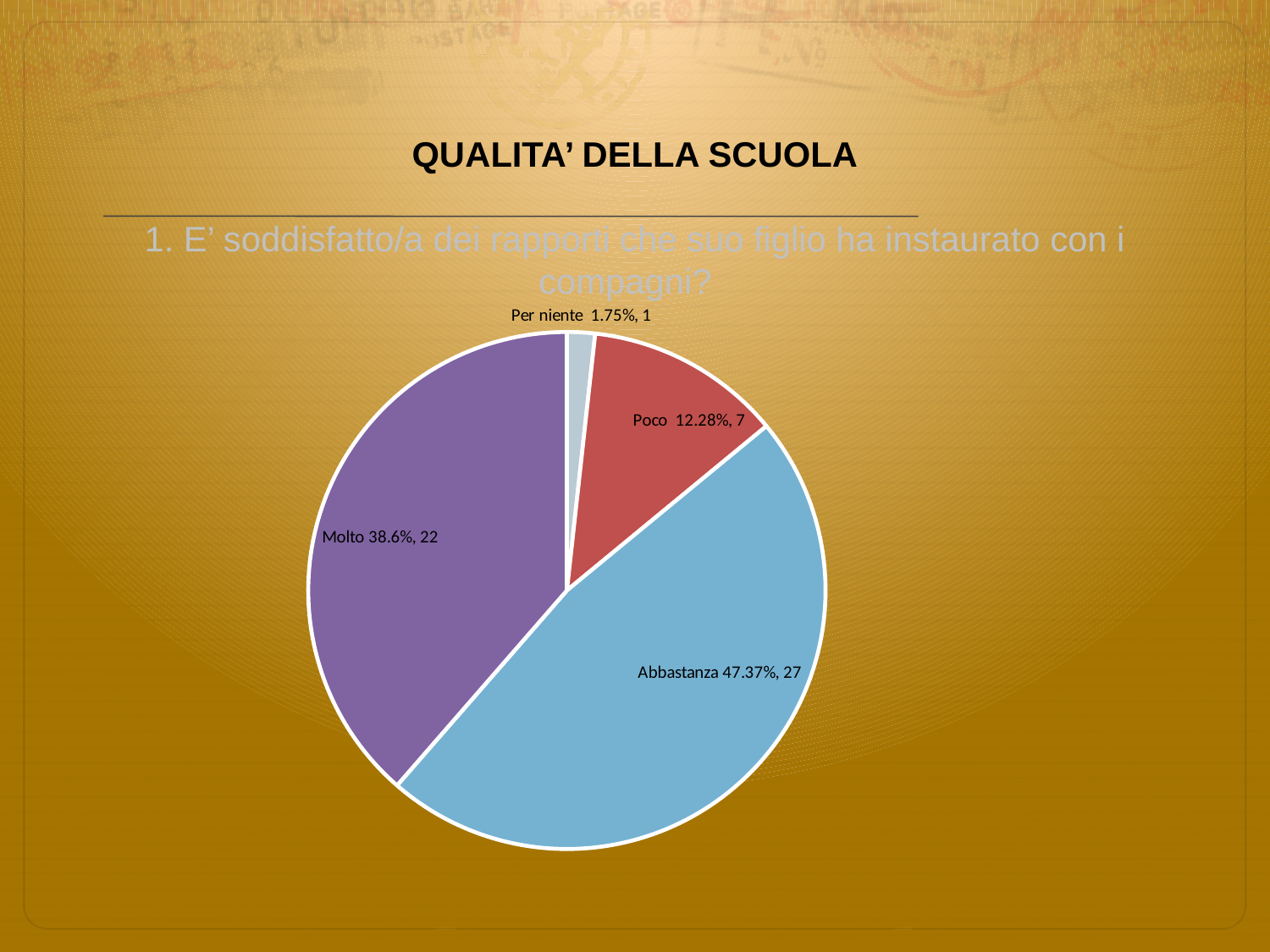
What is the count shown for Molto? 22 Which category has the smallest slice? Per niente What is the count shown for Poco? 7 What is the difference in count between Abbastanza and Molto? 5 What percentage share does the Abbastanza slice have? 47.37% How many slices does the pie chart have? 4 What percentage share does the Per niente slice have? 1.75% Which category has the largest slice? Abbastanza What colour is the Abbastanza slice? light blue Which is larger, the Molto slice or the Poco slice? Molto What is the total count across all slices? 57 What kind of chart is shown on the slide? pie chart